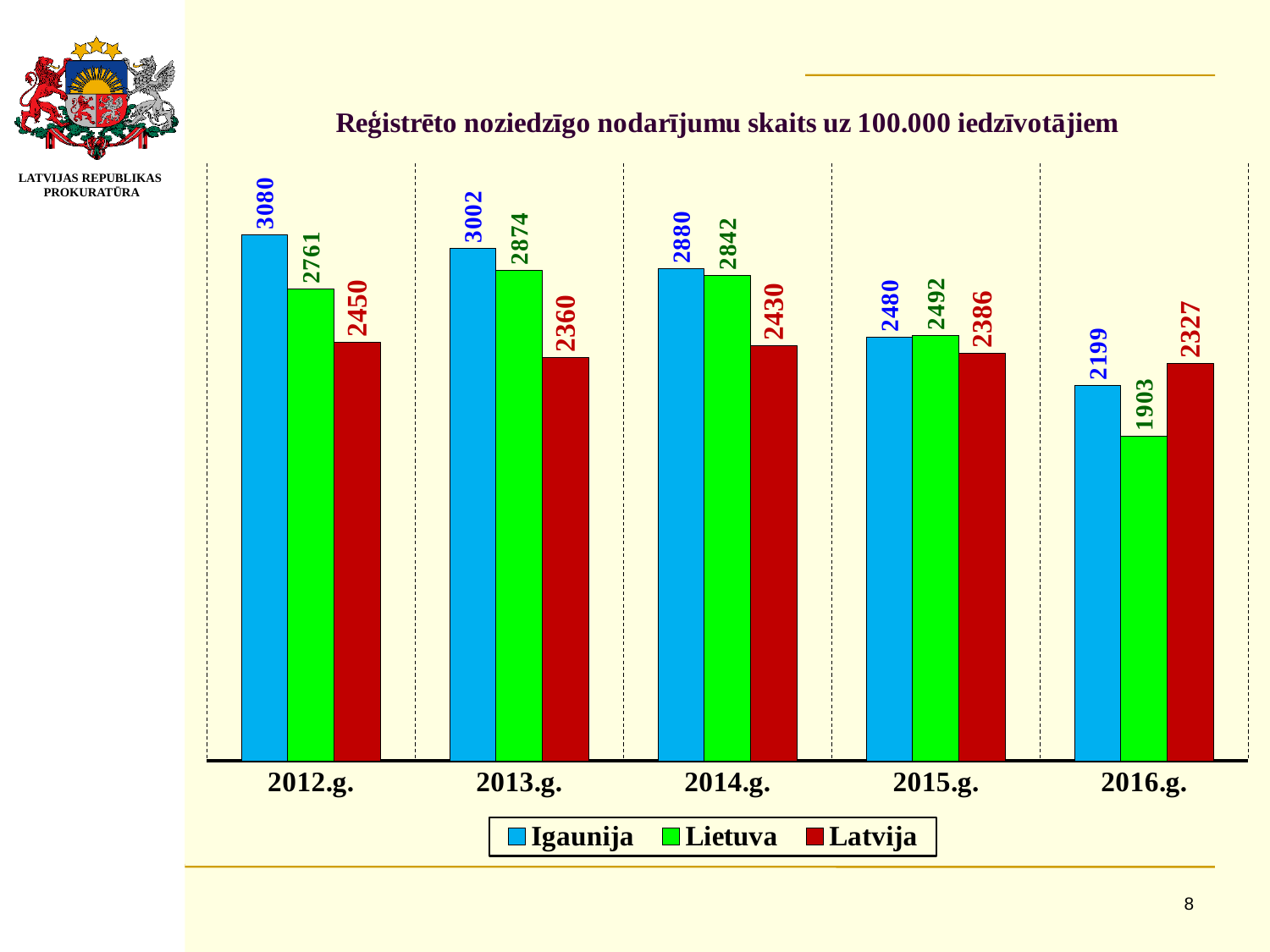
How many years are shown on the x axis? 5 Which year has the highest value for Igaunija? 2012.g. What is the value for Lietuva in 2016.g.? 1903 How many series does the legend list? 3 What is the difference between the Igaunija and Latvija values in 2013.g.? 642 What kind of chart is shown on the slide? bar chart What is the value for Igaunija in 2012.g.? 3080 What colour represents Latvija in the chart? red Which year has the lowest value for Lietuva? 2016.g. Which is larger in 2016.g., the value for Igaunija or the value for Latvija? Latvija What is the value for Latvija in 2014.g.? 2430 Do the values for Igaunija rise or fall from 2012.g. to 2016.g.? fall